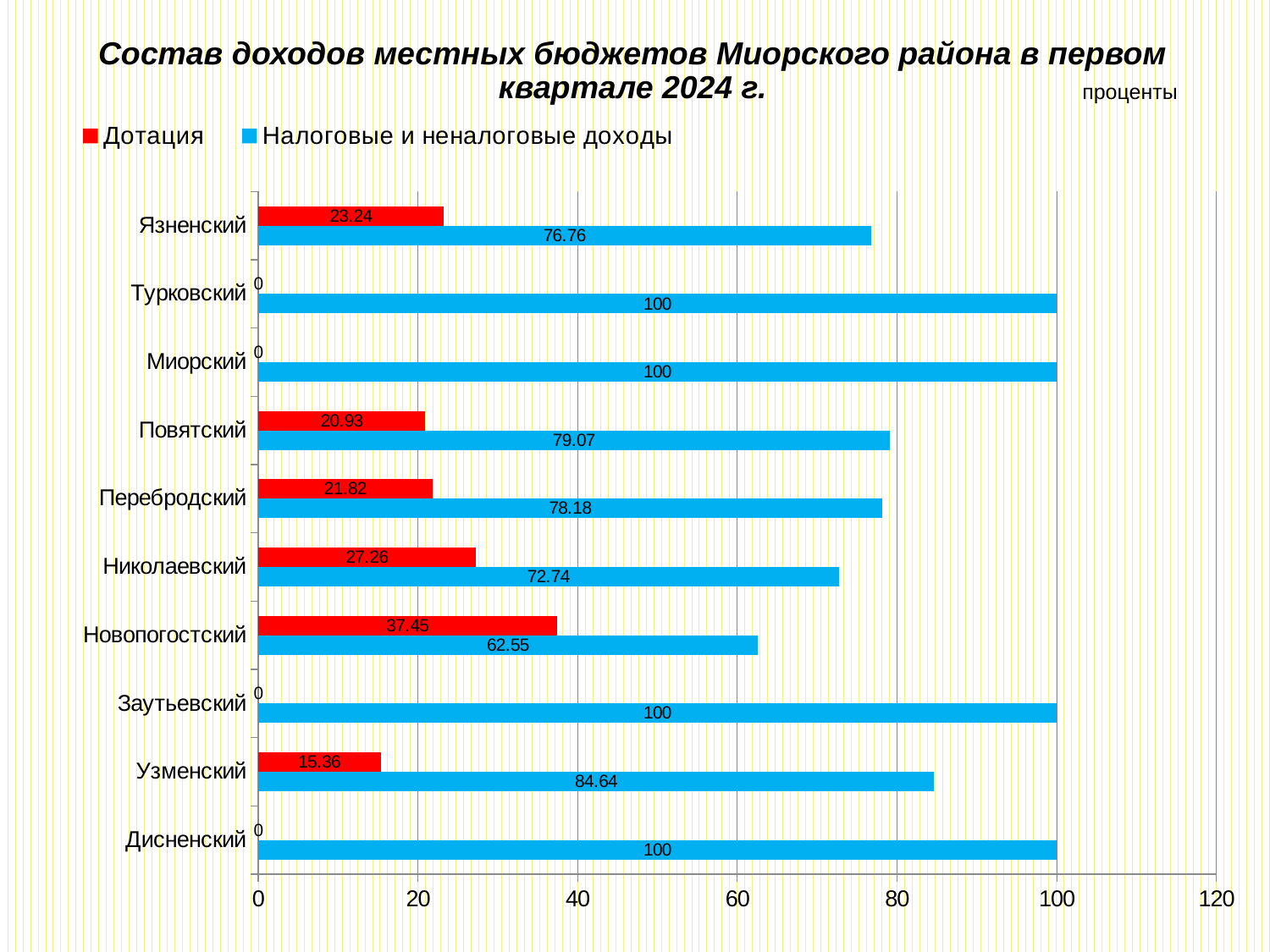
What is the Налоговые и неналоговые доходы value for Узменский? 84.64 What is the difference between the Налоговые и неналоговые доходы value and the Дотация value for Николаевский? 45.48 How many categories are shown on the chart? 10 What is the Дотация value for Новопогостский? 37.45 Which category has the highest Дотация value? Новопогостский Which is larger: the Дотация value for Язненский or for Повятский? Язненский What colour represents the Дотация series? Red What kind of chart is shown on the slide? Bar chart How many series does the legend list? 2 Which category has the lowest Налоговые и неналоговые доходы value? Новопогостский What is the Дотация value for Миорский? 0 What is the total of the Дотация and Налоговые и неналоговые доходы values for Перебродский? 100